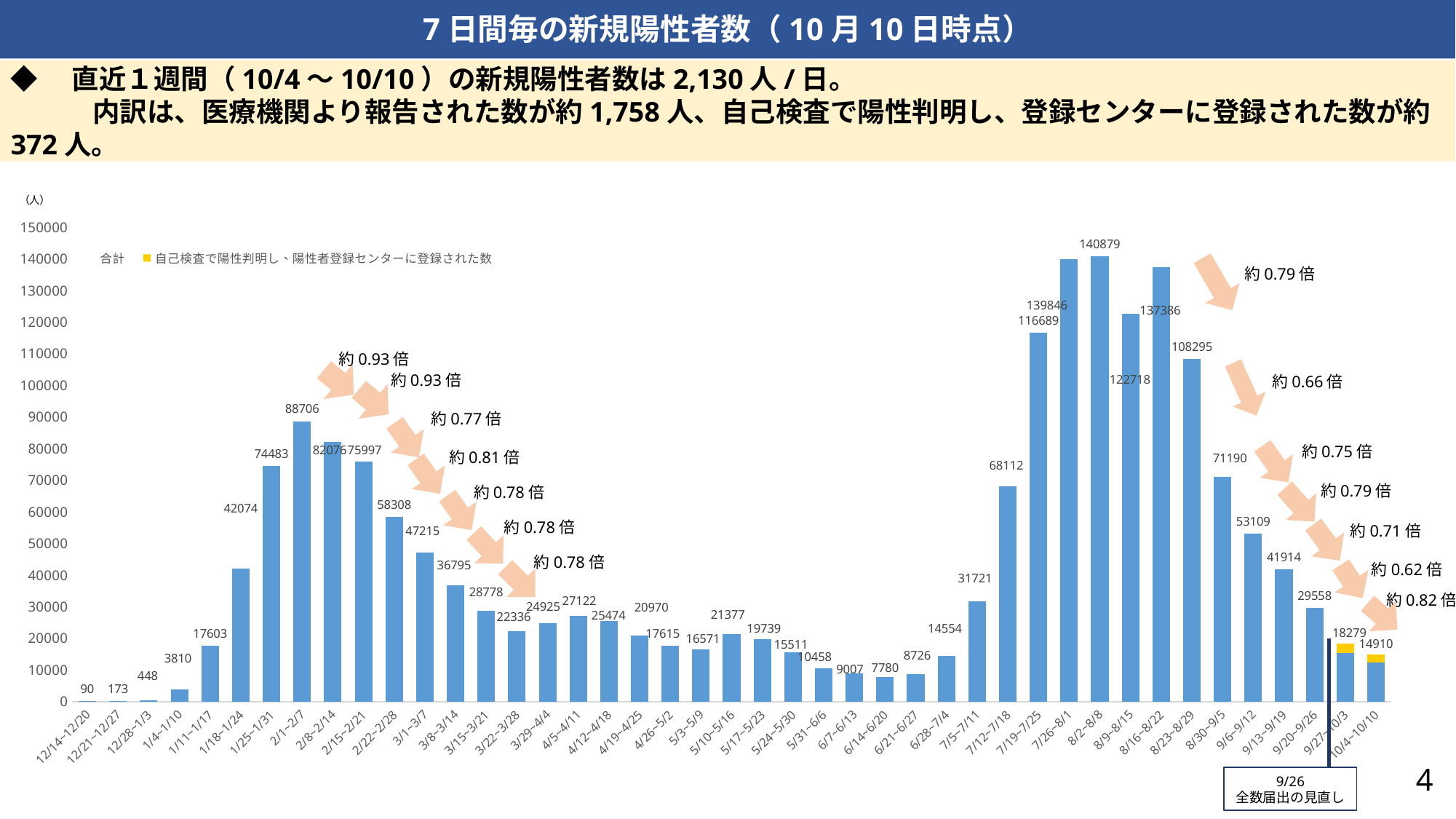
What is the value for the 10/4-10/10 period? 14910 What is the value for the 2/1-2/7 period? 88706 Which period has the highest value? 8/2-8/8 Which is larger, the value for 7/19-7/25 or the value for 8/23-8/29? 7/19-7/25 Is the value for 8/16-8/22 greater or less than 130000? greater What is the value for the 7/26-8/1 period? 139846 How many periods are shown on the x axis? 43 How many series does the legend list? 2 Which period has the lowest value? 12/14-12/20 What is the difference between the values for 9/27-10/3 and 10/4-10/10? 3369 What kind of chart is shown? bar chart Do the values rise or fall from 6/14-6/20 to 8/2-8/8? rise